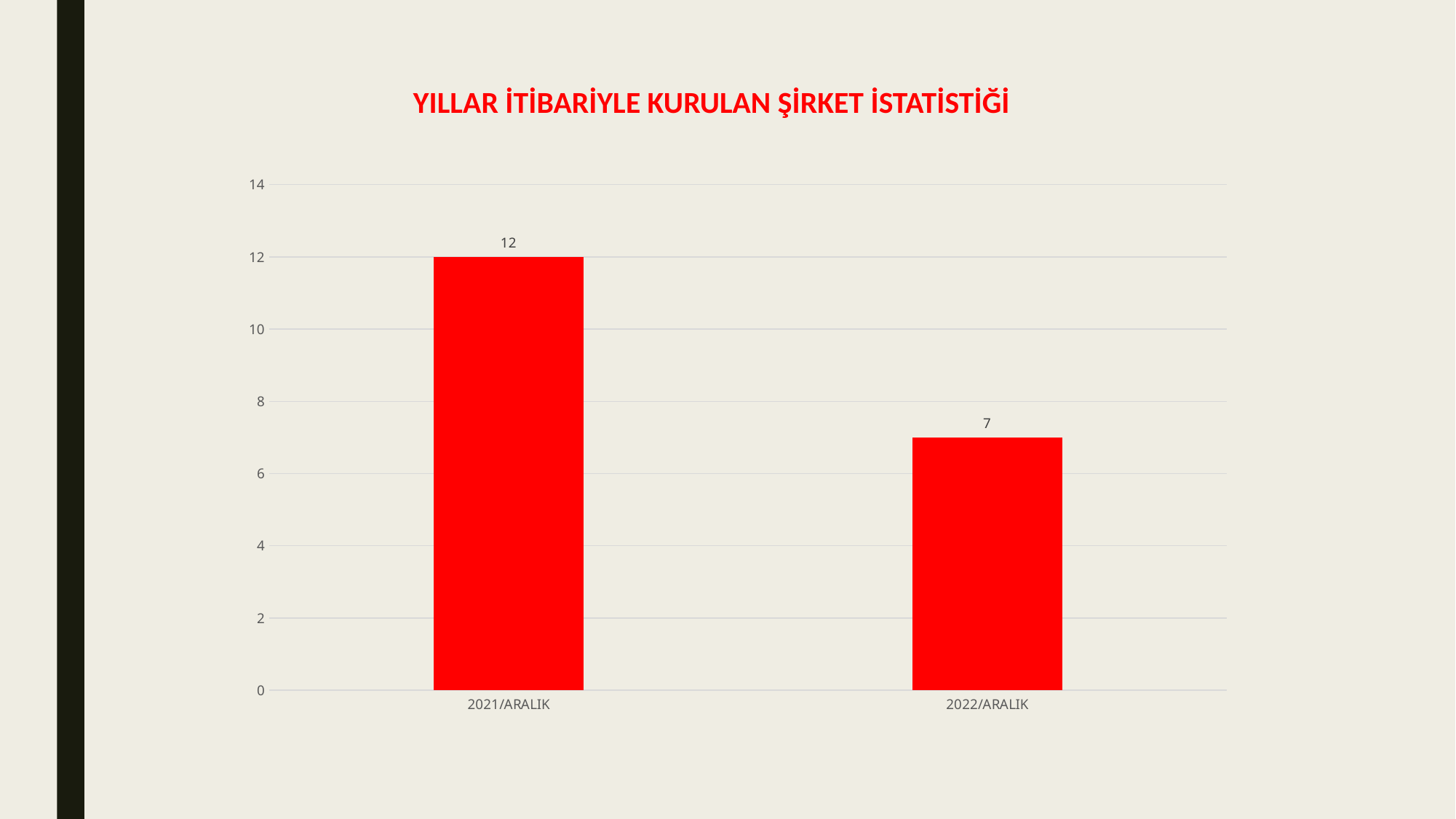
Which category has the lowest value? 2022/ARALIK Which category has the highest value? 2021/ARALIK How many categories are shown on the x axis? 2 What is the title of the chart? YILLAR İTİBARİYLE KURULAN ŞİRKET İSTATİSTİĞİ What kind of chart is shown on the slide? bar chart Is the value for 2022/ARALIK greater or less than 8? less What is the difference between the values for 2021/ARALIK and 2022/ARALIK? 5 What is the value for 2021/ARALIK? 12 Do the values rise or fall from 2021/ARALIK to 2022/ARALIK? fall What is the value for 2022/ARALIK? 7 Which is larger, the value for 2021/ARALIK or the value for 2022/ARALIK? 2021/ARALIK Is the value for 2021/ARALIK greater or less than 10? greater